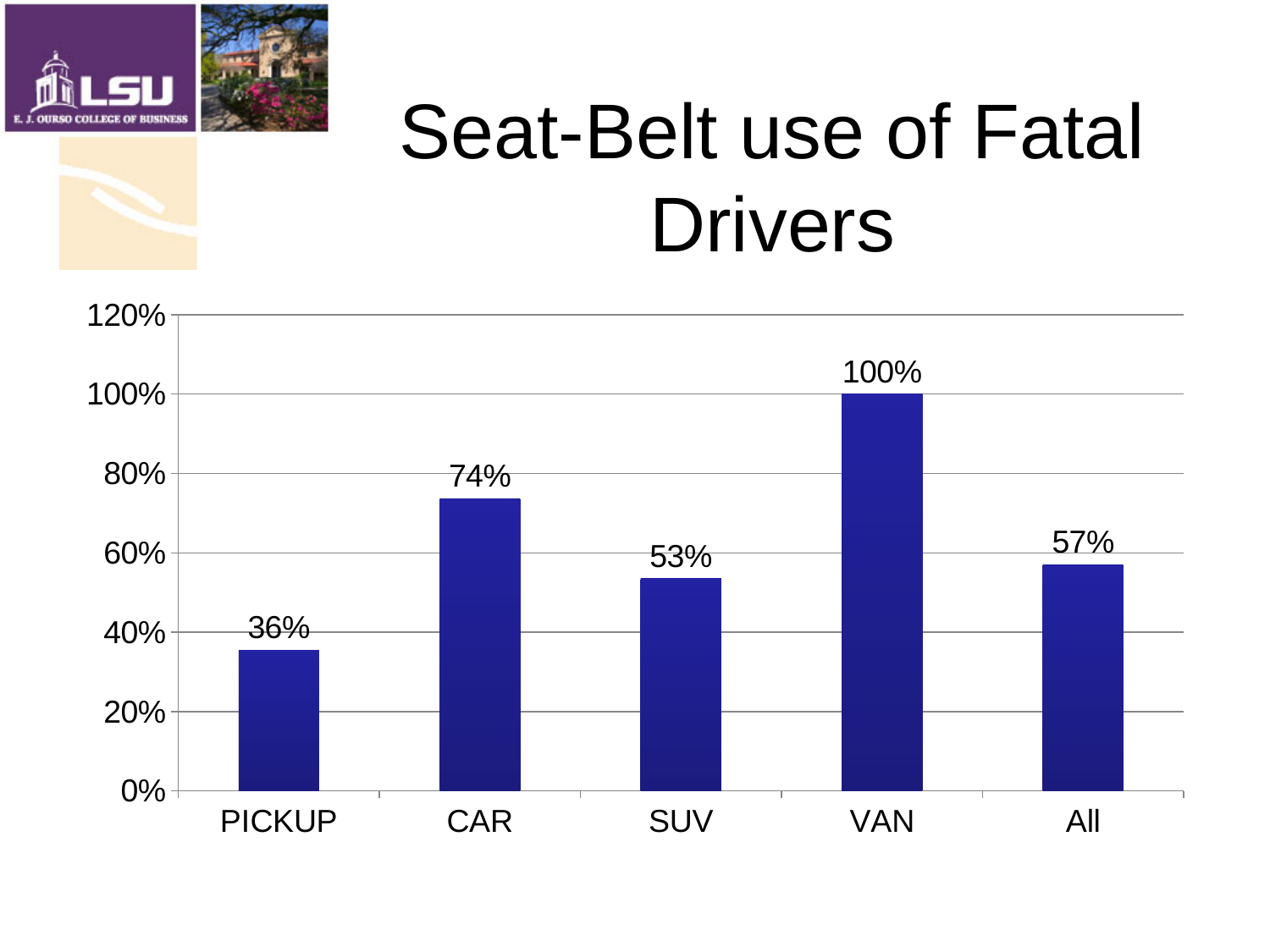
What kind of chart is shown on the slide? Bar chart What is the difference between the values for VAN and PICKUP? 64% What is the seat-belt use value for CAR? 74% Which category has the lowest seat-belt use? PICKUP Which is larger, the value for SUV or the value for All? All What is the seat-belt use value for All? 57% What is the seat-belt use value for SUV? 53% Which category has the highest seat-belt use? VAN What is the title of the slide containing the chart? Seat-Belt use of Fatal Drivers How many categories are shown on the x axis? 5 What is the difference between the values for CAR and SUV? 21% What is the seat-belt use value for PICKUP? 36%